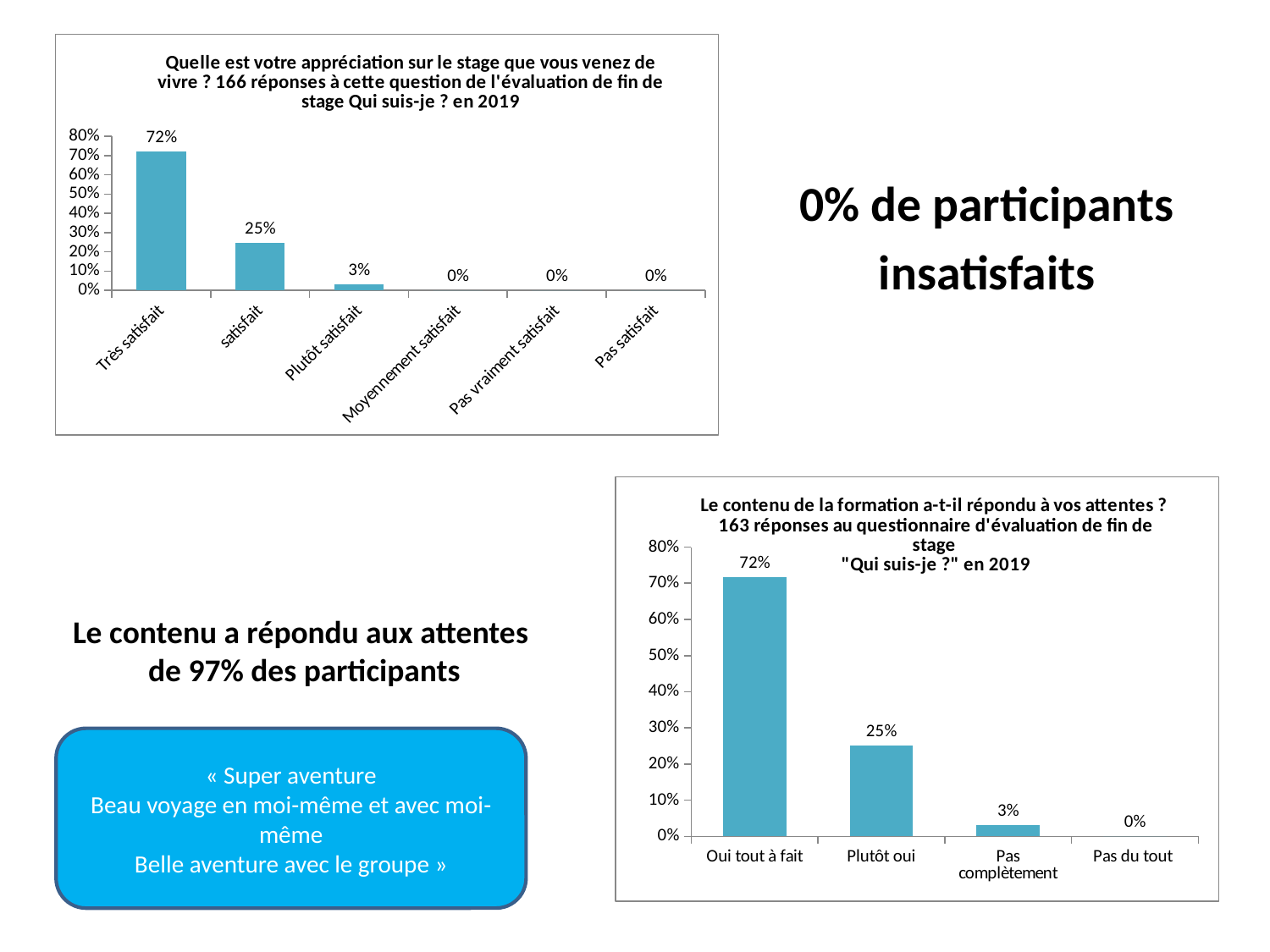
In the top-left chart (appreciation of the stage), how many categories are shown on the x axis? 6 In the bottom-right chart (content meeting expectations), which category has the lowest value? Pas du tout In the bottom-right chart (content meeting expectations), what is the value for "Plutôt oui"? 25% In the top-left chart (appreciation of the stage), which category has the highest value? Très satisfait In the top-left chart (appreciation of the stage), what is the value for "Pas satisfait"? 0% In the top-left chart (appreciation of the stage), what is the difference between "Très satisfait" and "satisfait"? 47% In the top-left chart (appreciation of the stage), what is the value for "Très satisfait"? 72% In the top-left chart (appreciation of the stage), what is the value for "Plutôt satisfait"? 3% In the bottom-right chart (content meeting expectations), what is the value for "Pas complètement"? 3% What kind of chart is the bottom-right chart (content meeting expectations)? Bar chart In the bottom-right chart (content meeting expectations), which is larger: "Oui tout à fait" or "Plutôt oui"? Oui tout à fait In the bottom-right chart (content meeting expectations), how many categories are shown on the x axis? 4